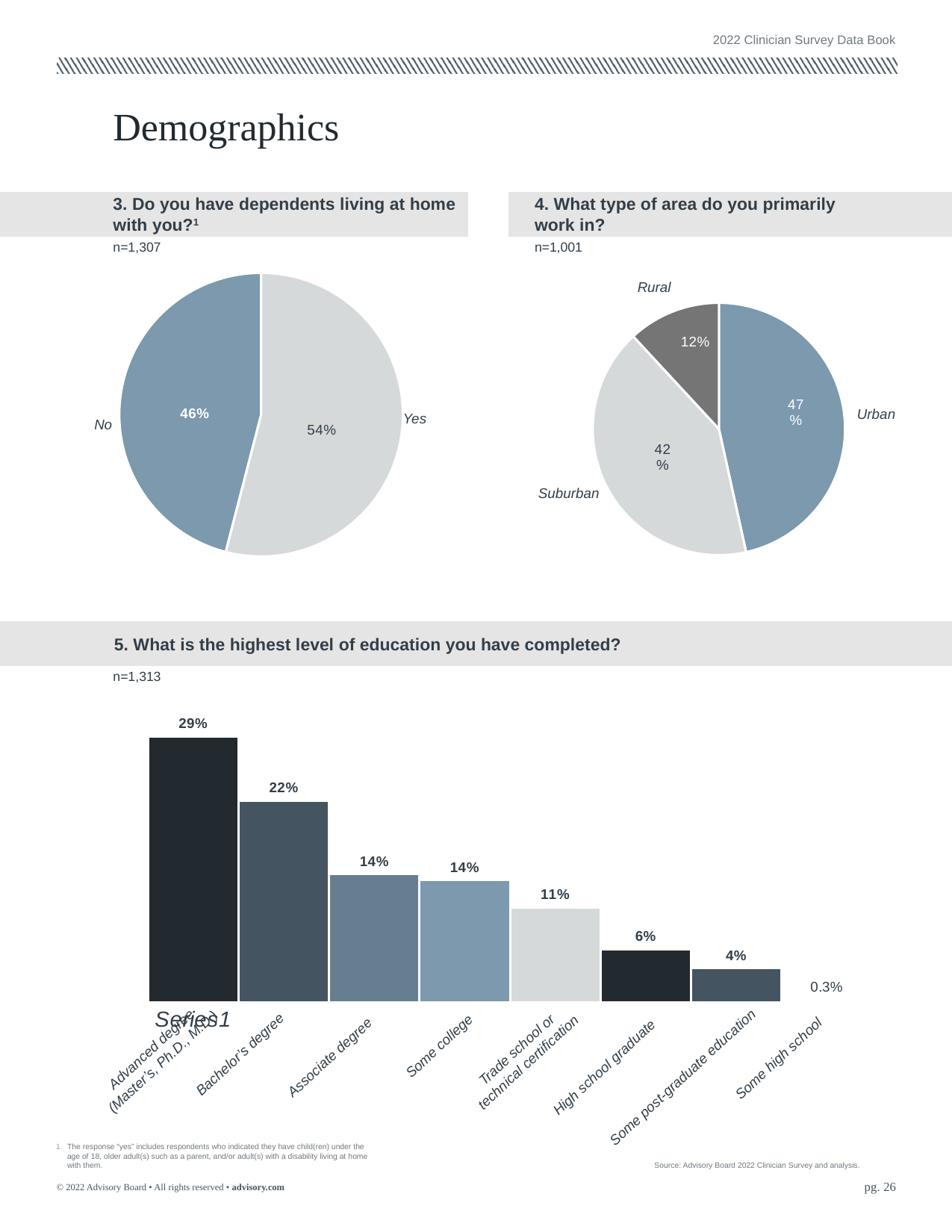
In the chart '4. What type of area do you primarily work in?', which area type has the largest share? Urban In the chart '5. What is the highest level of education you have completed?', which category has the highest value? Advanced degree (Master's, Ph.D., M.D.) In the chart '5. What is the highest level of education you have completed?', which category has the lowest value? Some high school In the chart '5. What is the highest level of education you have completed?', what is the difference between Advanced degree and High school graduate? 23% In the chart '4. What type of area do you primarily work in?', what is the difference between the Urban and Suburban shares? 5% In the chart '4. What type of area do you primarily work in?', how many slices does the pie have? 3 What kind of chart is used for '3. Do you have dependents living at home with you?' Pie chart In the chart '3. Do you have dependents living at home with you?', what share of respondents answered Yes? 54% In the chart '5. What is the highest level of education you have completed?', what is the value for Bachelor's degree? 22% In the chart '5. What is the highest level of education you have completed?', how many education categories are shown? 8 In the chart '4. What type of area do you primarily work in?', what percentage of respondents work in a Rural area? 12% In the chart '3. Do you have dependents living at home with you?', what share of respondents answered No? 46%